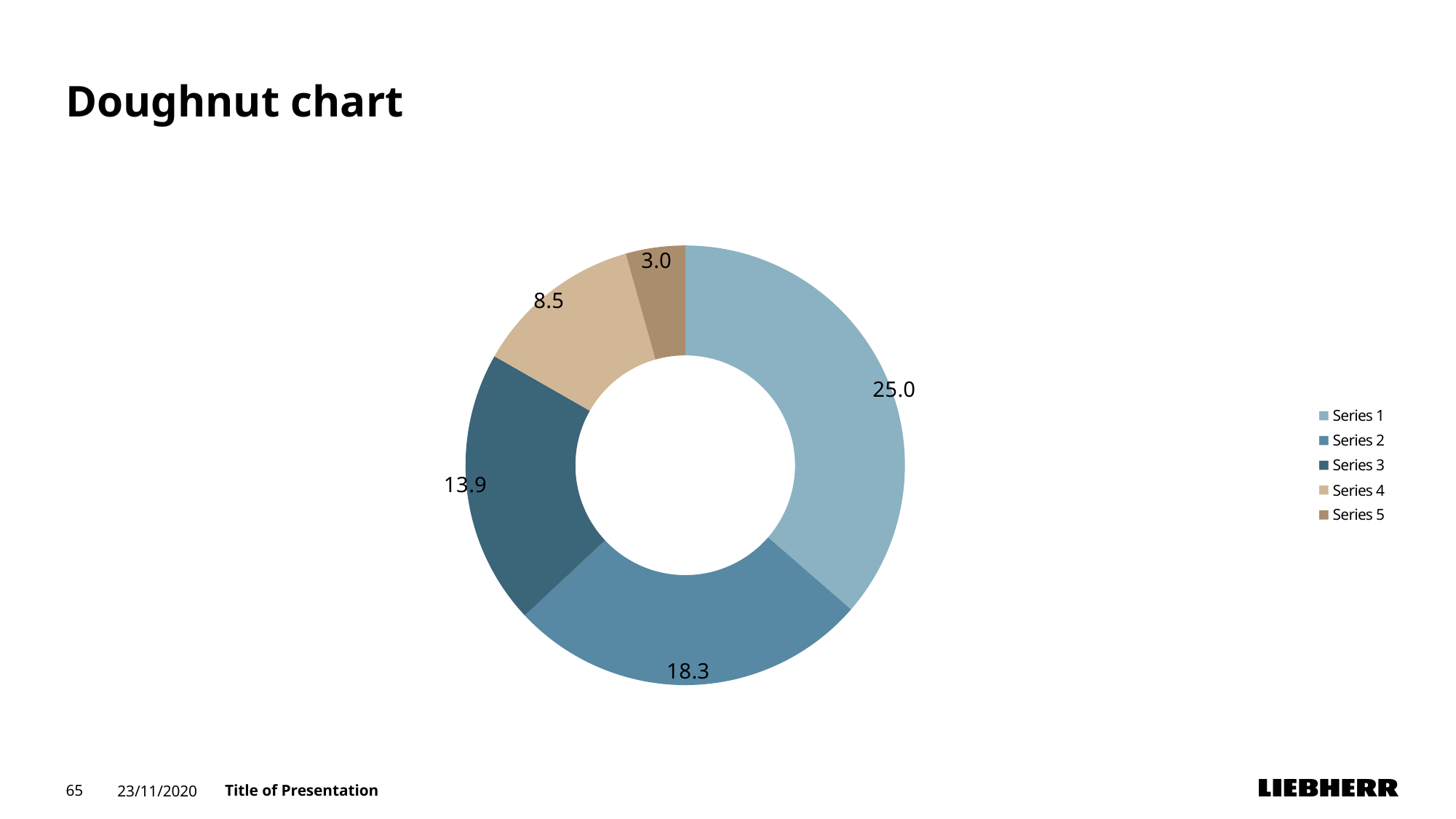
What is the value for Series 3? 13.9 Which is larger, the value for Series 3 or the value for Series 4? Series 3 What is the value for Series 2? 18.3 What is the value for Series 5? 3.0 Which series has the smallest value? Series 5 Which series has the largest value? Series 1 How many series does the legend list? 5 What is the title of the slide? Doughnut chart What is the value for Series 4? 8.5 What is the value for Series 1? 25.0 What kind of chart is shown on the slide? Doughnut chart What is the difference between the values for Series 1 and Series 2? 6.7